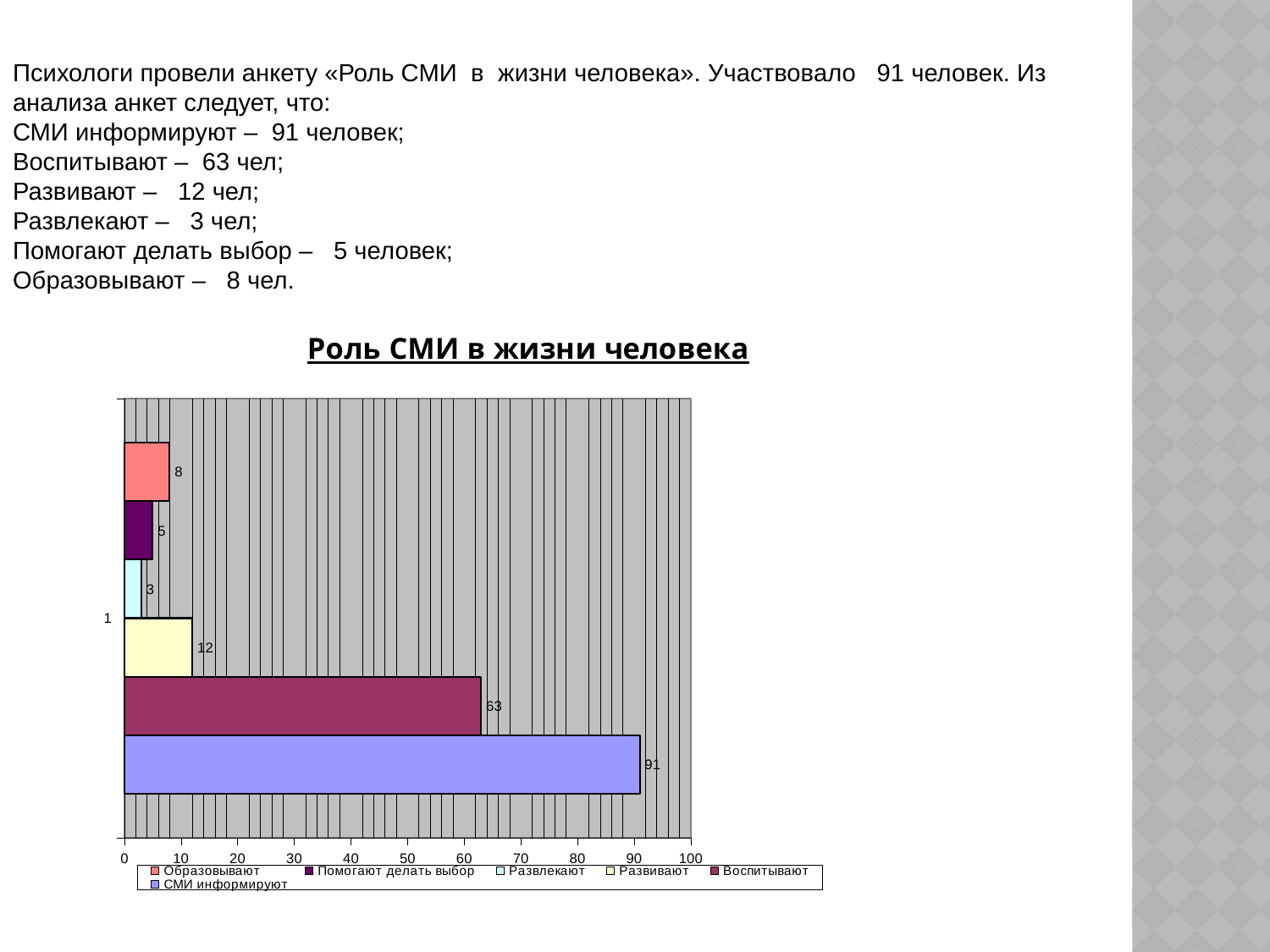
Is the value for «Воспитывают» greater or less than 50? greater Which series has the highest value in the chart? СМИ информируют How many series does the legend list? 6 What is the value for «Развивают» in the chart? 12 Which series has the lowest value in the chart? Развлекают What type of chart is shown on the slide? bar chart What is the title of the chart? Роль СМИ в жизни человека Which is larger, the value for «Образовывают» or the value for «Помогают делать выбор»? Образовывают What is the value for «СМИ информируют» in the chart? 91 What is the value for «Развлекают» in the chart? 3 What is the value for «Воспитывают» in the chart? 63 What is the difference between the values for «СМИ информируют» and «Воспитывают»? 28